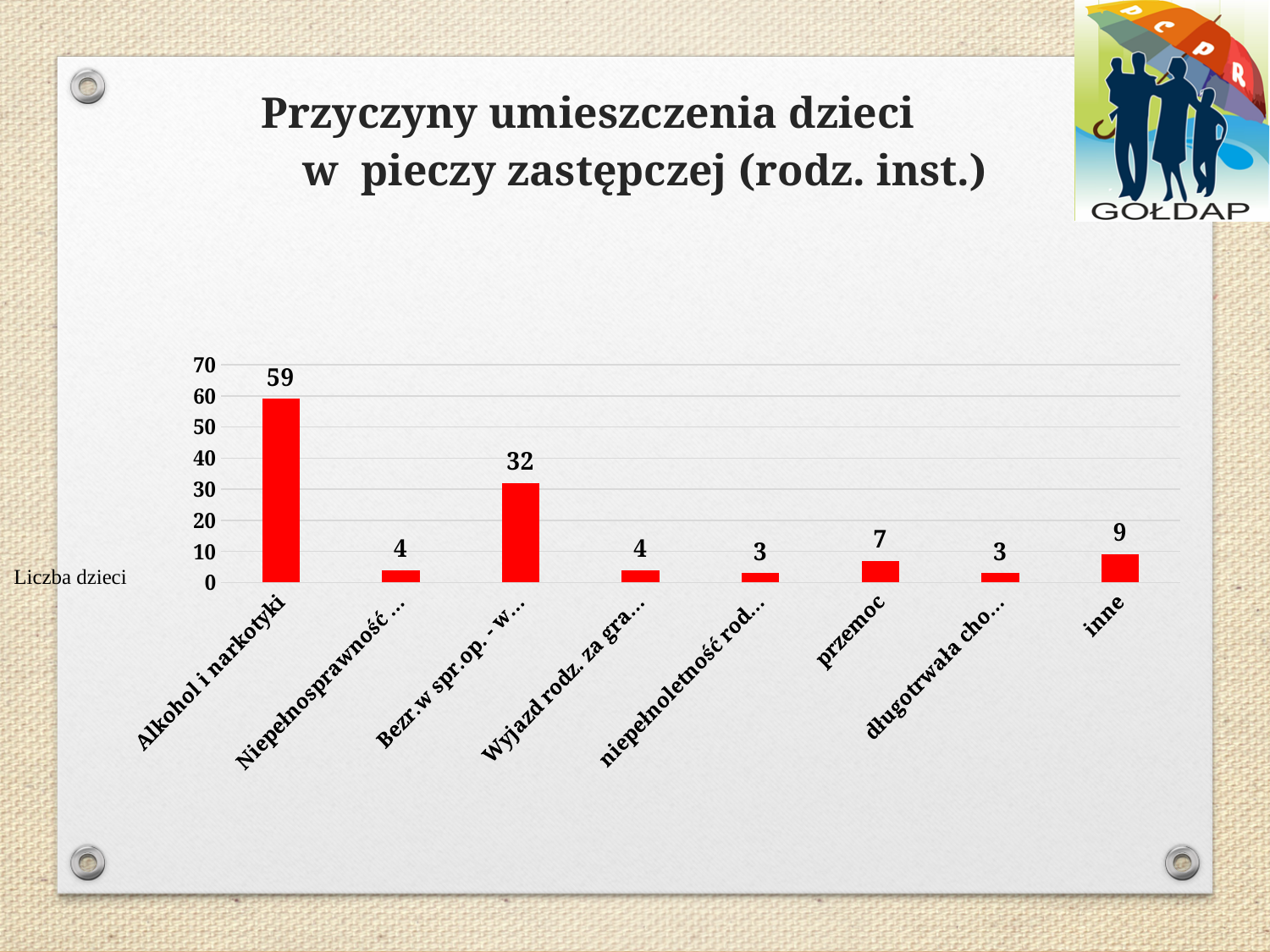
What is the title of the chart on the slide? Przyczyny umieszczenia dzieci w pieczy zastępczej (rodz. inst.) What is the difference between the values for "inne" and "przemoc"? 2 Is the value for "Alkohol i narkotyki" greater or less than 50? greater What is the difference between the values for "Alkohol i narkotyki" and "inne"? 50 What is the value for "inne"? 9 Which category has the highest value? Alkohol i narkotyki What is the value for "przemoc"? 7 How many categories are shown on the x axis? 8 What is the value for "Alkohol i narkotyki"? 59 Is the value for "przemoc" greater or less than 10? less Which is larger, the value for "przemoc" or the value for "inne"? inne What kind of chart is shown on the slide? bar chart